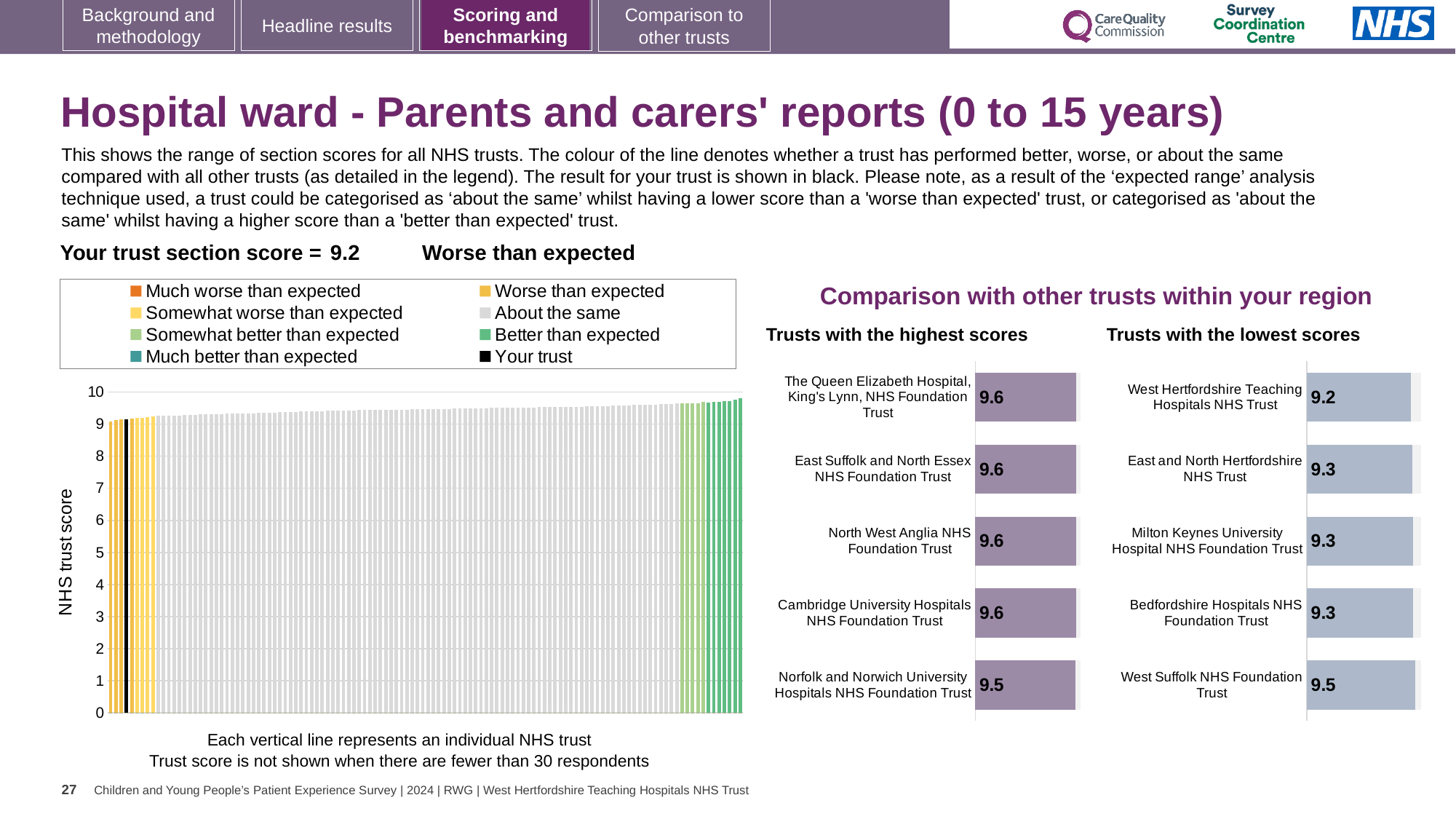
On the 'Trusts with the lowest scores' chart, which trust has the lowest score? West Hertfordshire Teaching Hospitals NHS Trust On the 'NHS trust score' chart, are all the trust scores greater or less than 8? greater What kind of chart is the 'NHS trust score' chart on the left of the slide? bar chart On the 'Trusts with the highest scores' chart, which trust has the lowest score? Norfolk and Norwich University Hospitals NHS Foundation Trust On the 'Trusts with the lowest scores' chart, what is the score for West Suffolk NHS Foundation Trust? 9.5 On the 'NHS trust score' chart, what colour is used for 'Your trust'? black On the 'Trusts with the highest scores' chart, what is the score for Norfolk and Norwich University Hospitals NHS Foundation Trust? 9.5 On the 'Trusts with the lowest scores' chart, which has the higher score: Milton Keynes University Hospital NHS Foundation Trust or West Suffolk NHS Foundation Trust? West Suffolk NHS Foundation Trust On the 'NHS trust score' chart, what is your trust's section score? 9.2 On the 'Trusts with the highest scores' chart, how many trusts are shown? 5 How many entries does the legend above the 'NHS trust score' chart list? 8 On the 'Trusts with the lowest scores' chart, what is the difference between the scores of West Suffolk NHS Foundation Trust and West Hertfordshire Teaching Hospitals NHS Trust? 0.3